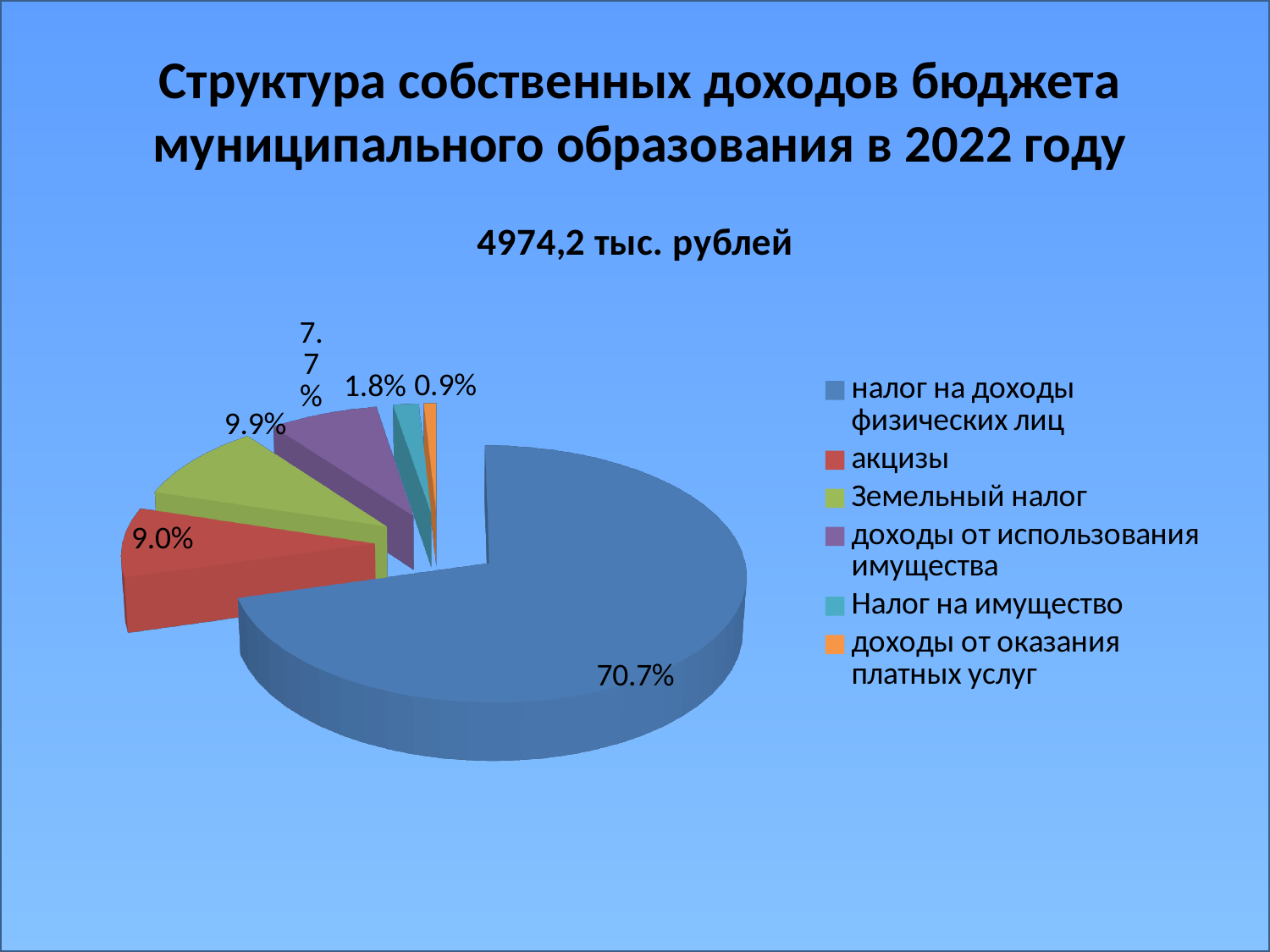
What share of the pie does налог на доходы физических лиц represent? 70.7% What is the difference in percentage points between the share for акцизы and the share for доходы от использования имущества? 1.3 What is the value shown for доходы от использования имущества? 7.7% What is the value shown for Земельный налог? 9.9% What total amount is stated above the chart? 4974,2 тыс. рублей Which category has the smallest slice of the pie? доходы от оказания платных услуг What kind of chart is shown on the slide? pie chart What is the value shown for акцизы? 9.0% What is the value shown for Налог на имущество? 1.8% How many categories does the legend list? 6 Which is larger, the share for Земельный налог or the share for акцизы? Земельный налог Which category has the largest slice of the pie? налог на доходы физических лиц